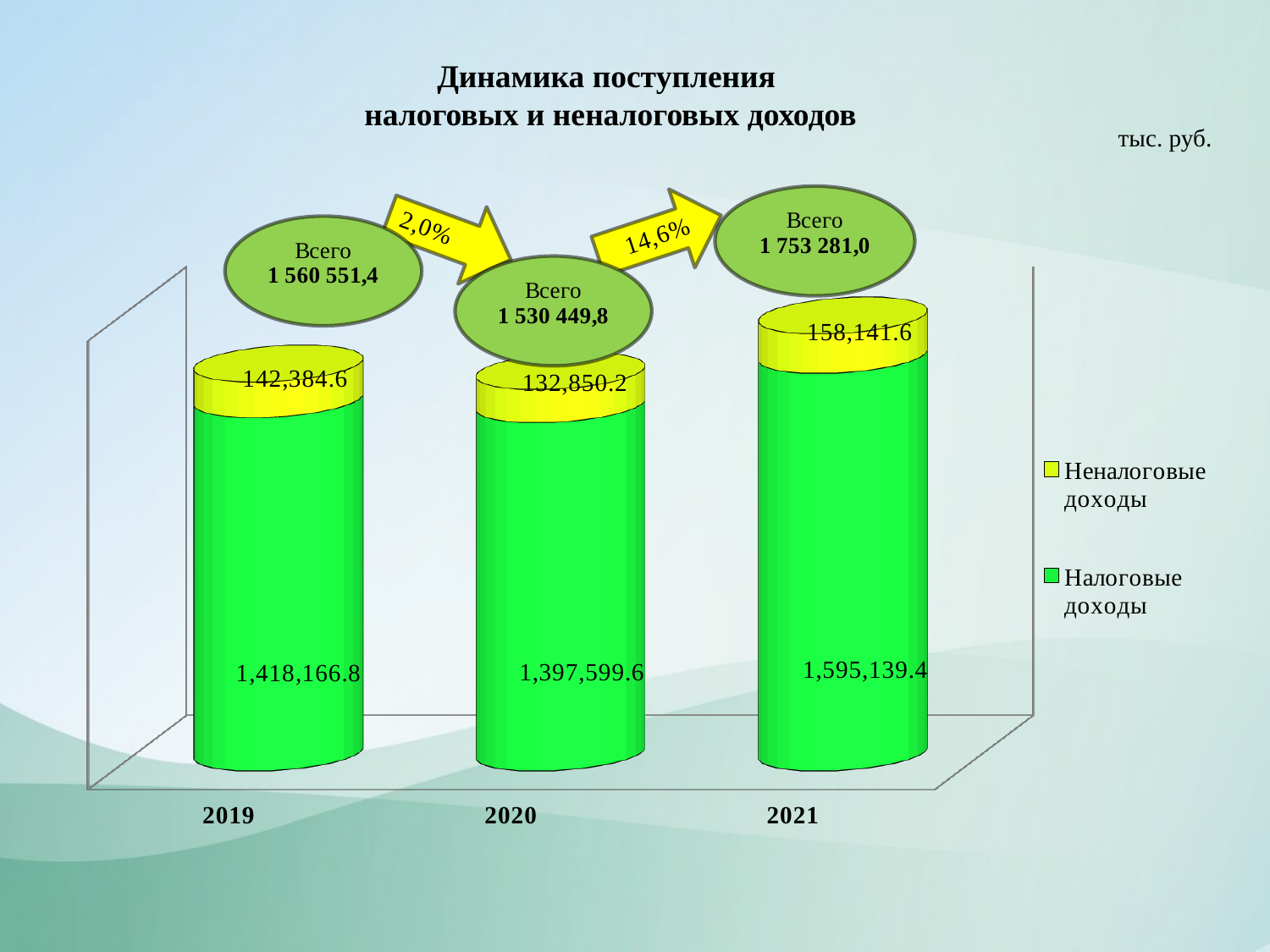
What is the value of Неналоговые доходы for 2021? 158,141.6 What is the total (Всего) shown for 2021? 1 753 281,0 How many series does the legend list? 2 What is the value of Налоговые доходы for 2020? 1,397,599.6 Which is larger: Налоговые доходы in 2019 or in 2020? 2019 What kind of chart is shown on the slide? Stacked bar chart What is the total (Всего) shown for 2020? 1 530 449,8 Which year has the highest value of Налоговые доходы? 2021 What is the difference between Неналоговые доходы in 2021 and in 2020? 25,291.4 Which year has the lowest value of Неналоговые доходы? 2020 What is the value of Неналоговые доходы for 2019? 142,384.6 What is the value of Налоговые доходы for 2021? 1,595,139.4